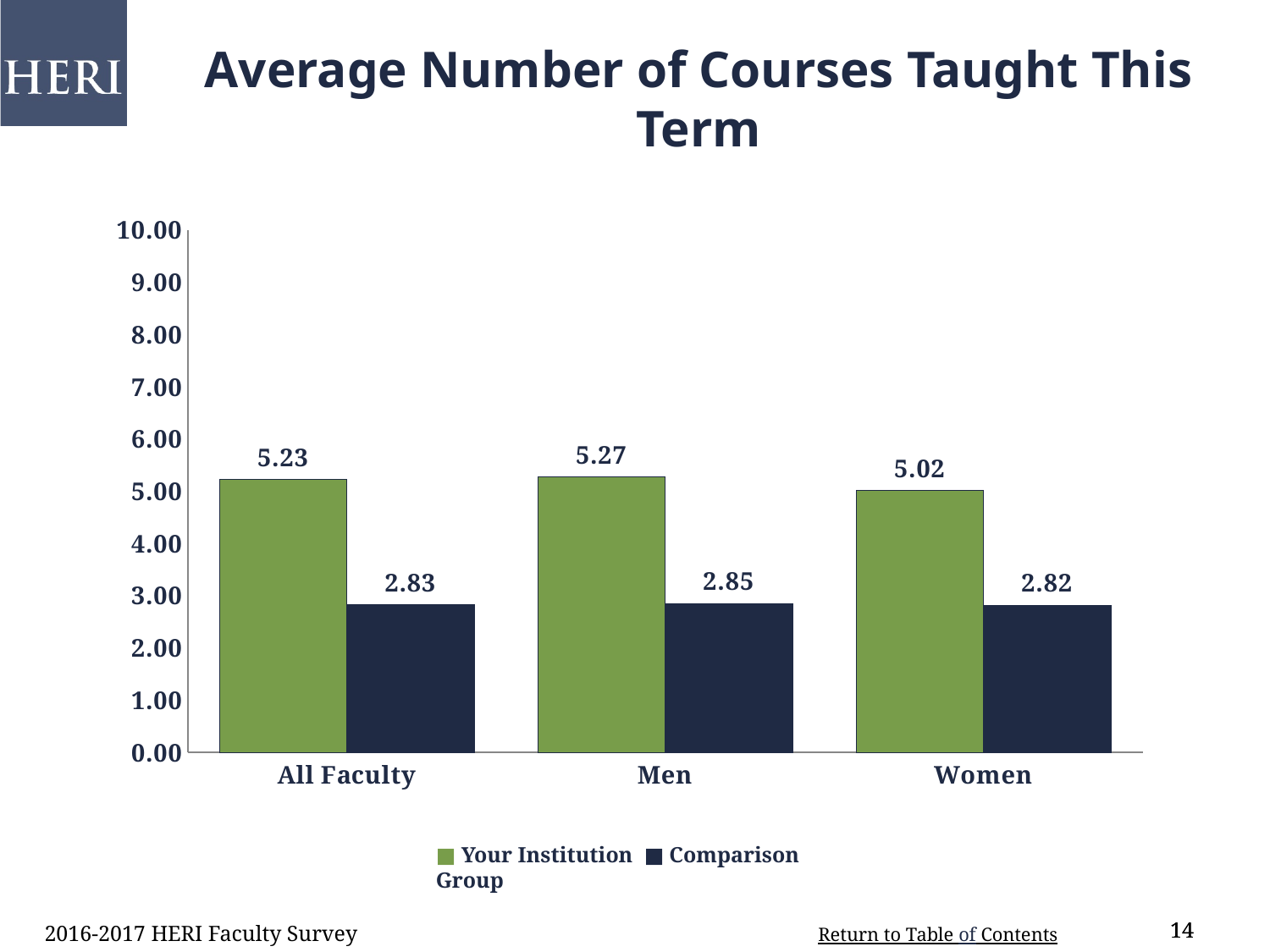
Which category has the lowest value for Your Institution? Women What is the value for Your Institution for All Faculty? 5.23 How many categories are shown on the x axis? 3 What is the difference between Your Institution and Comparison Group for Women? 2.20 What kind of chart is shown on the slide? Bar chart Which category has the highest value for Your Institution? Men How many series does the legend list? 2 Is the value for Your Institution for Women greater or less than 4.00? greater Which is larger for Men: Your Institution or Comparison Group? Your Institution What is the difference between Your Institution and Comparison Group for All Faculty? 2.40 What is the value for Your Institution for Men? 5.27 What is the value for Comparison Group for Women? 2.82